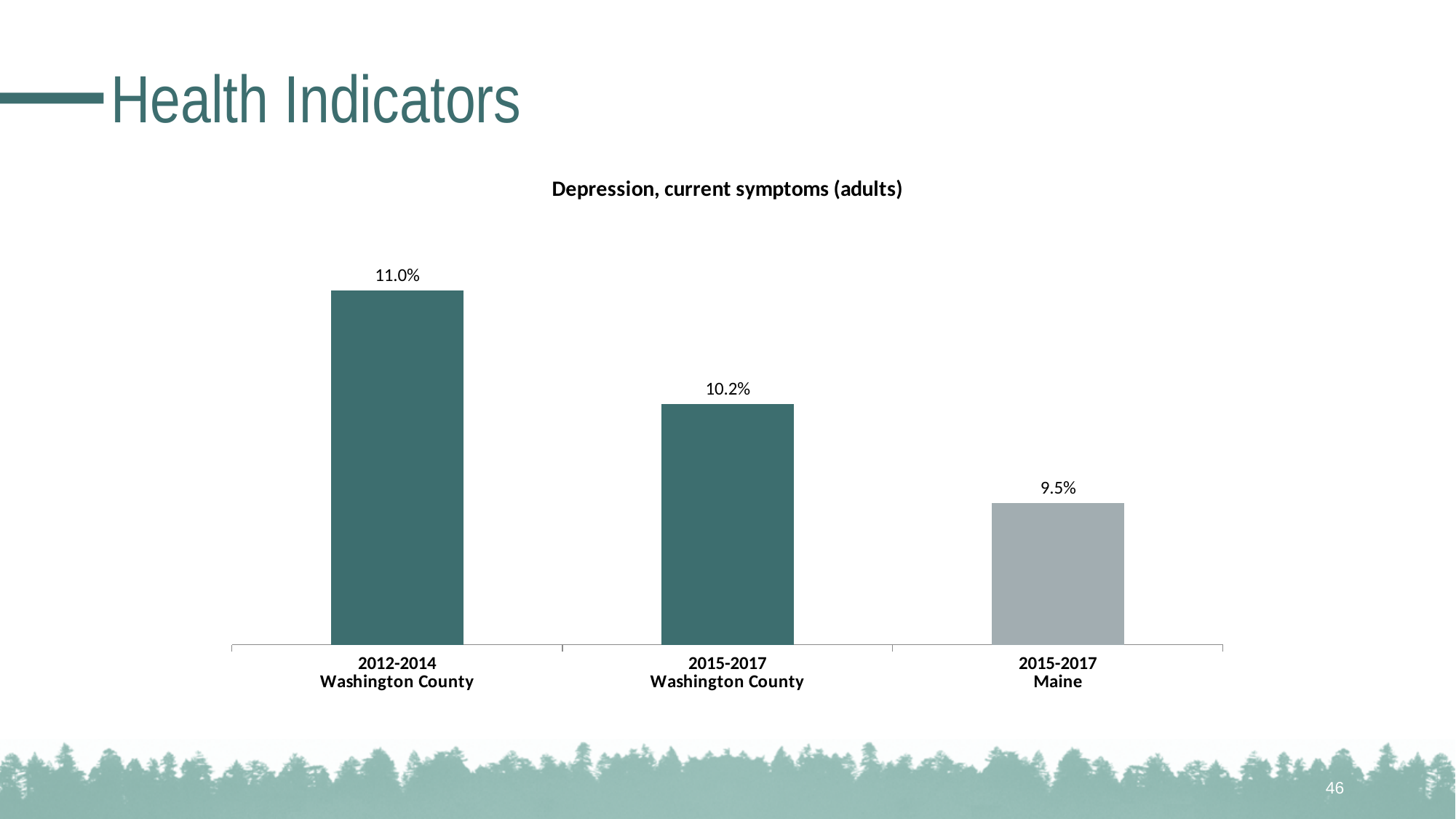
What is the difference between the 2012-2014 Washington County value and the 2015-2017 Washington County value? 0.8% How many bars are shown in the chart? 3 What kind of chart is shown on the slide? Bar chart Do the values rise or fall from left to right across the chart? Fall Which category has the highest value? 2012-2014 Washington County What is the value for 2015-2017 Maine? 9.5% What is the value for 2012-2014 Washington County? 11.0% What is the title of the chart? Depression, current symptoms (adults) Which category has the lowest value? 2015-2017 Maine Which is larger, the value for 2015-2017 Washington County or the value for 2015-2017 Maine? 2015-2017 Washington County What is the difference between the 2015-2017 Washington County value and the 2015-2017 Maine value? 0.7% What is the value for 2015-2017 Washington County? 10.2%